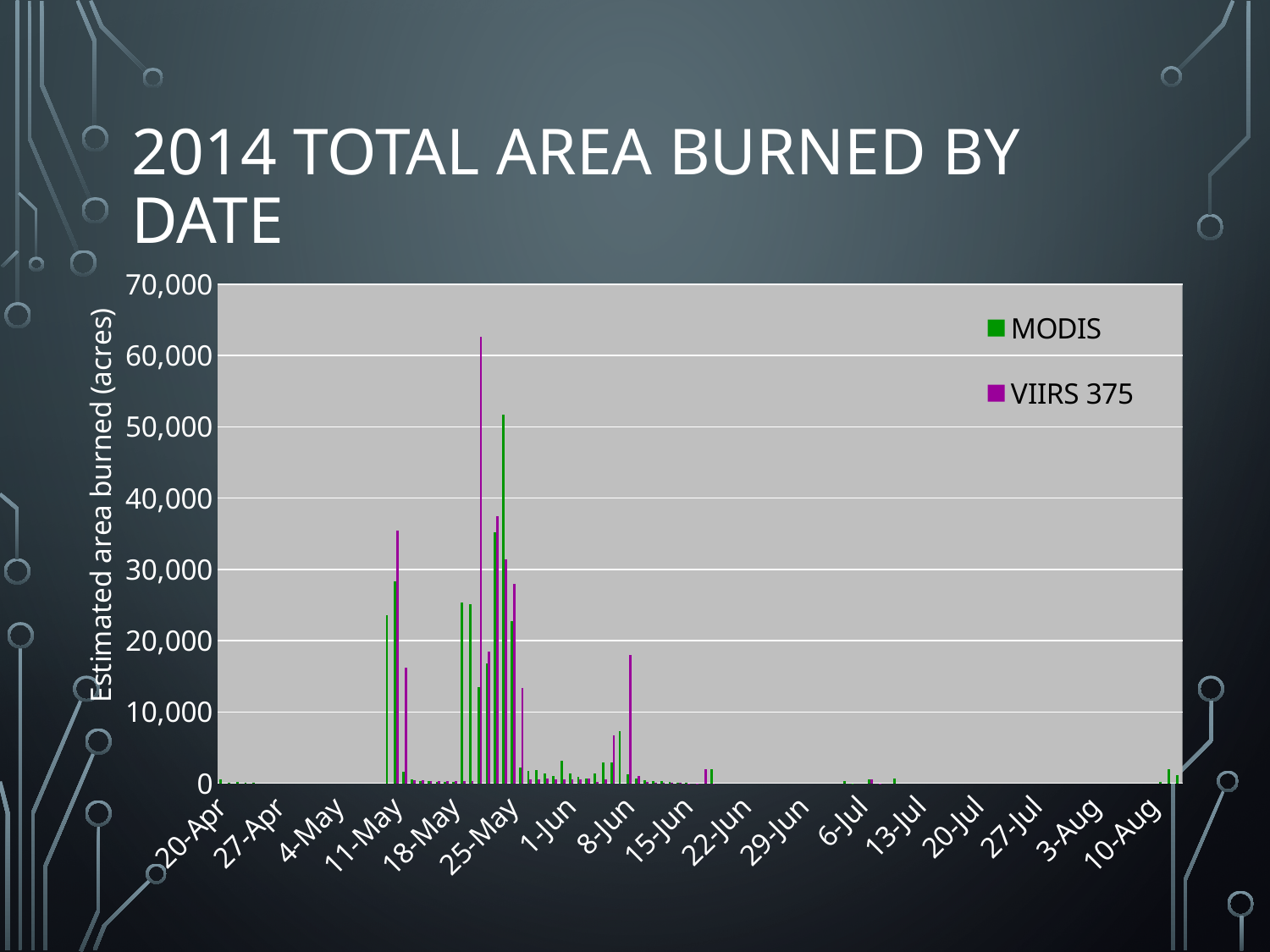
What kind of chart is shown on the slide? bar chart After the peak in late May, do the burned-area values generally rise or fall toward August? fall How many series does the legend list? 2 Is the tallest MODIS bar greater or less than 40,000 acres? greater Is the largest bar after 22-Jun greater or less than 10,000 acres? less How many date labels are shown on the x axis? 17 Around which x-axis date do the tallest bars of both series occur? 25-May Which series is drawn in green? MODIS Which series has the tallest single bar on the chart? VIIRS 375 What are the two series named in the legend? MODIS and VIIRS 375 Is the tallest VIIRS 375 bar greater or less than 60,000 acres? greater